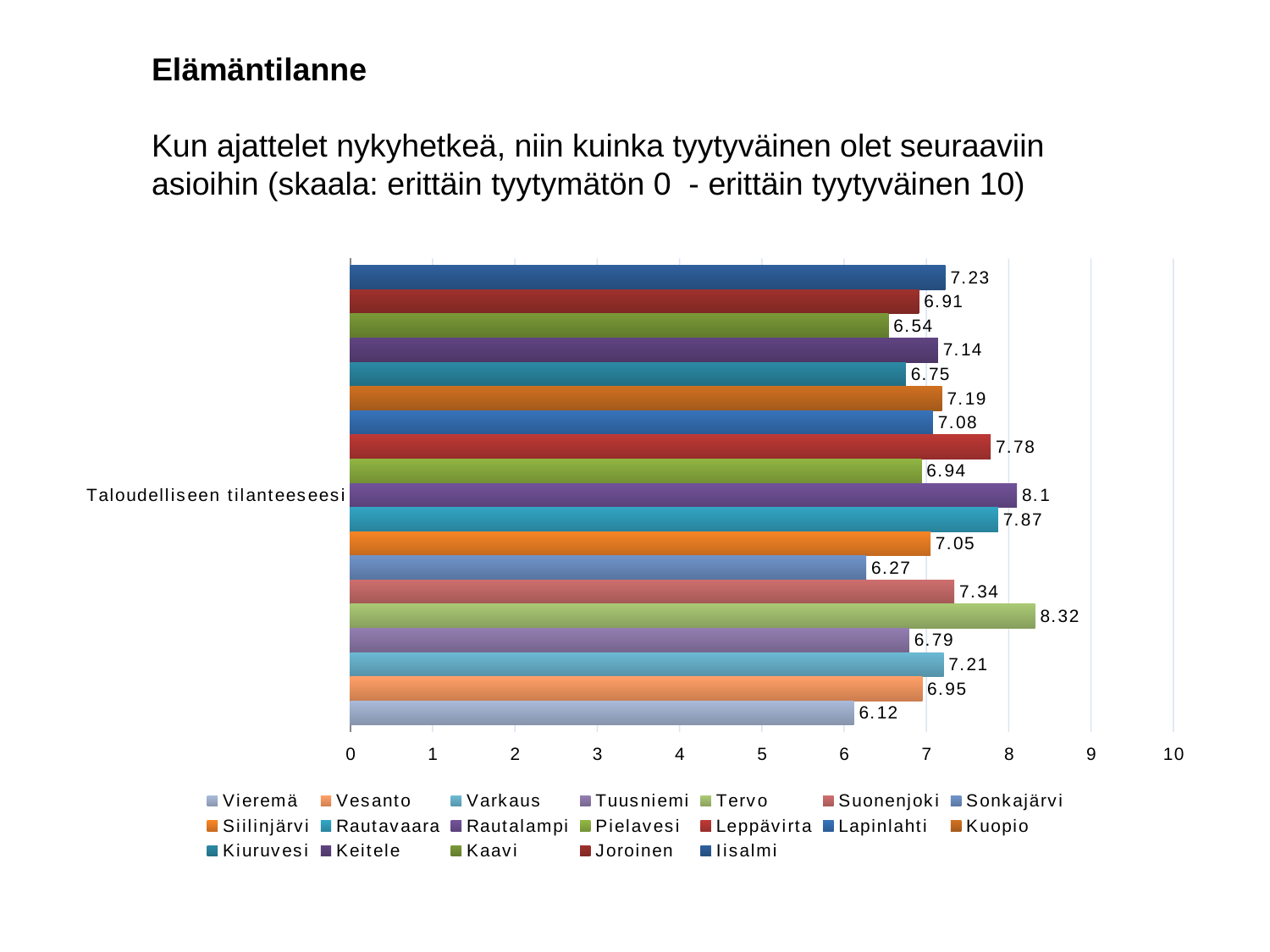
What is the value for Tervo? 8.32 Which municipality has the highest value for Taloudelliseen tilanteeseesi? Tervo What kind of chart is shown on the slide? bar chart What is the difference between the values for Tervo and Vieremä? 2.2 What is the value for Iisalmi? 7.23 Is the value for Sonkajärvi greater or less than 7? less What is the value for Rautalampi? 8.1 How many categories are shown on the vertical axis? 1 Which municipality has the lowest value for Taloudelliseen tilanteeseesi? Vieremä What is the category label shown on the vertical axis? Taloudelliseen tilanteeseesi Which is larger, the value for Rautavaara or the value for Leppävirta? Rautavaara How many series does the legend list? 19